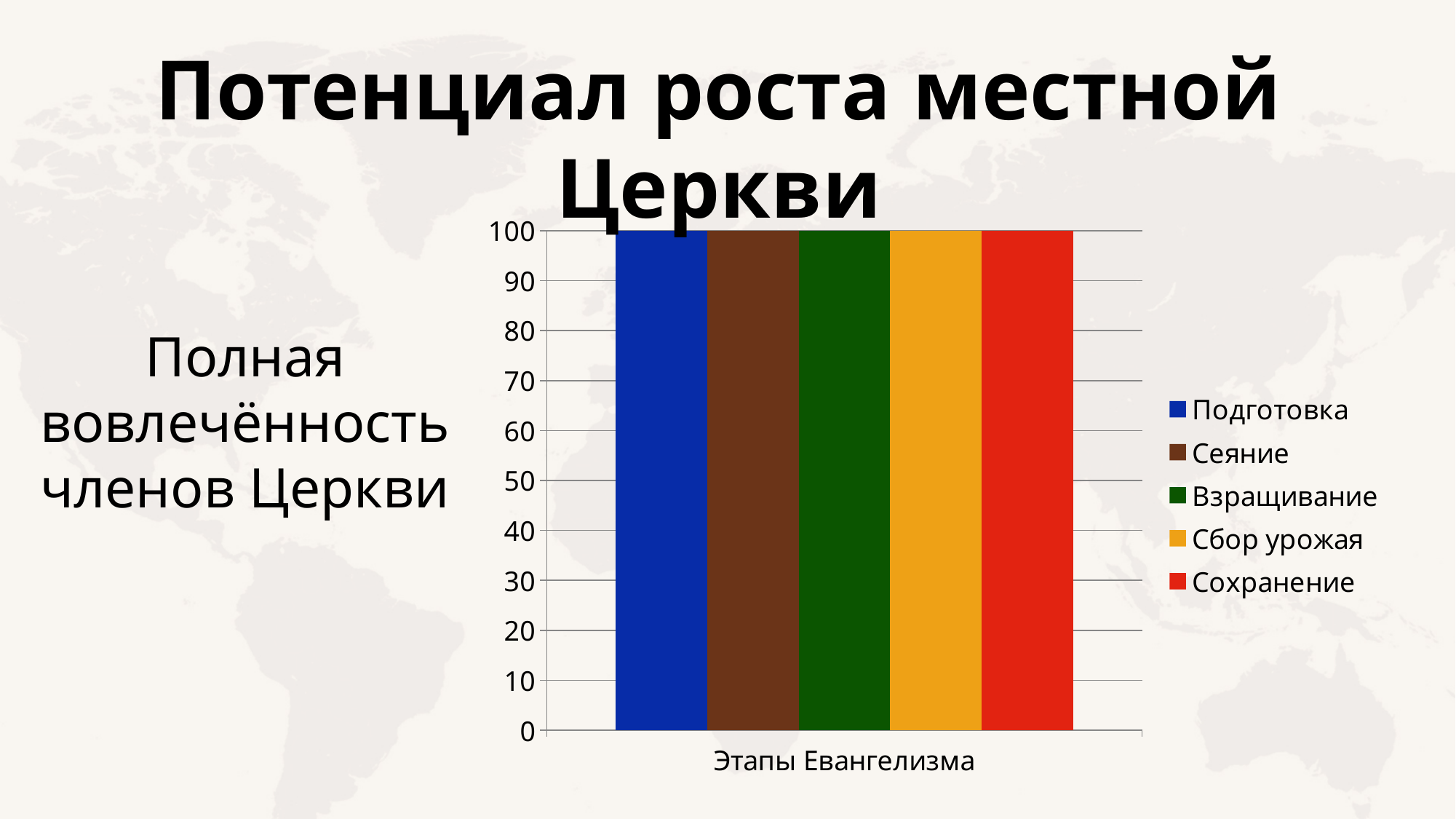
How many series does the legend list? 5 What kind of chart is shown on the slide? bar chart What is the value of the Сохранение bar? 100 What is the value of the Подготовка bar? 100 How many categories are shown on the x axis? 1 What is the value of the Сеяние bar? 100 What is the difference between the Подготовка and Сохранение bars? 0 Which series is shown in red in the legend? Сохранение What is the label of the category on the x axis? Этапы Евангелизма Is the value for Сбор урожая greater or less than 90? greater Is the value for Взращивание greater or less than 50? greater What is the highest value shown on the y axis? 100